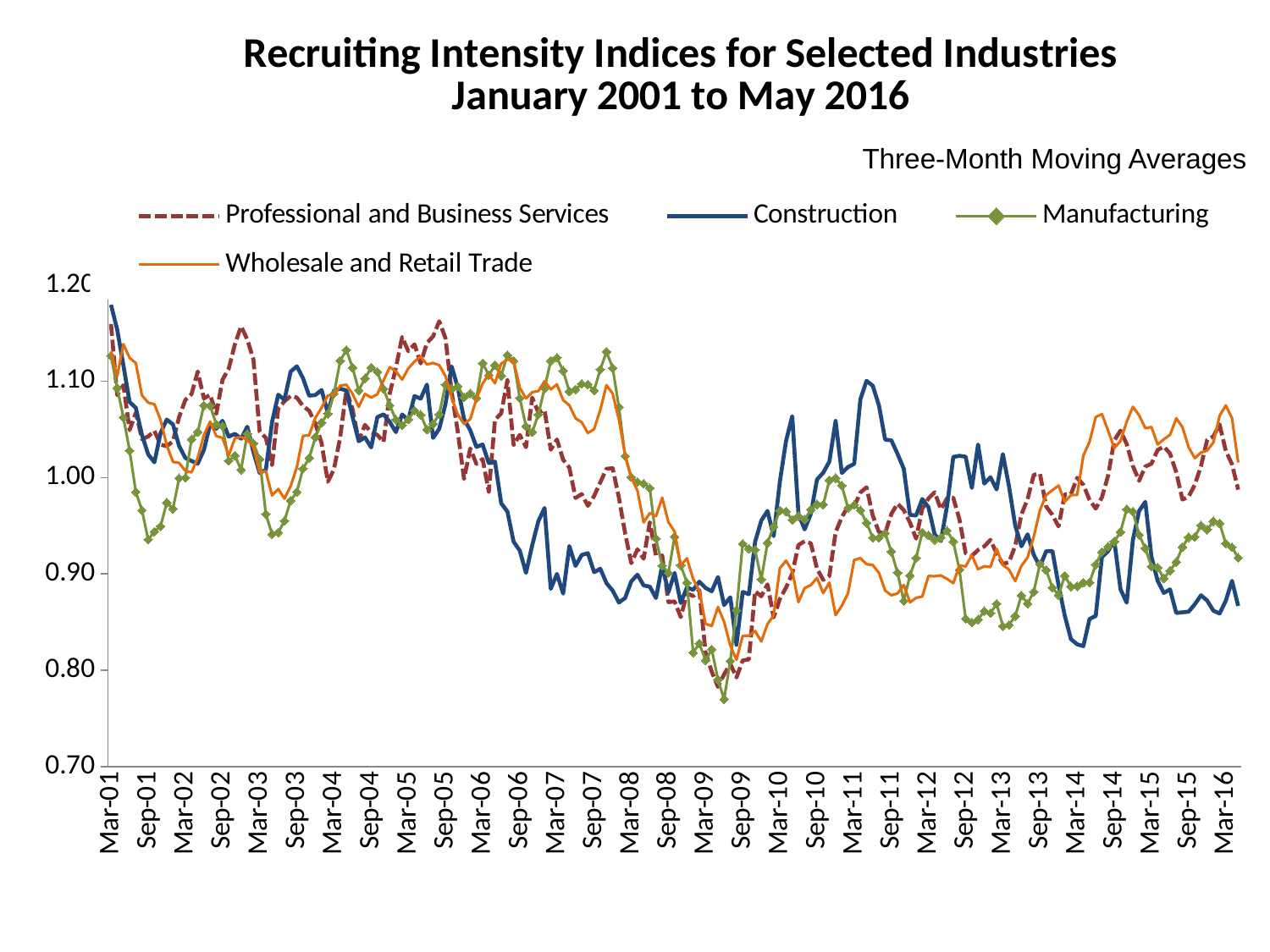
Which series has the highest value at Mar-11? Construction Which series has the lowest value around mid-2009? Manufacturing What is the title of the chart? Recruiting Intensity Indices for Selected Industries January 2001 to May 2016 Is the Construction value at Mar-14 greater or less than 0.90? less Is the lowest Manufacturing value, reached around mid-2009, greater or less than 0.80? less Is the Construction value at Mar-01 greater or less than 1.10? greater At Mar-16, which is larger: the Wholesale and Retail Trade value or the Construction value? Wholesale and Retail Trade Which series is drawn with a dashed line? Professional and Business Services How many series does the legend list? 4 What kind of chart is shown on the slide? Line chart